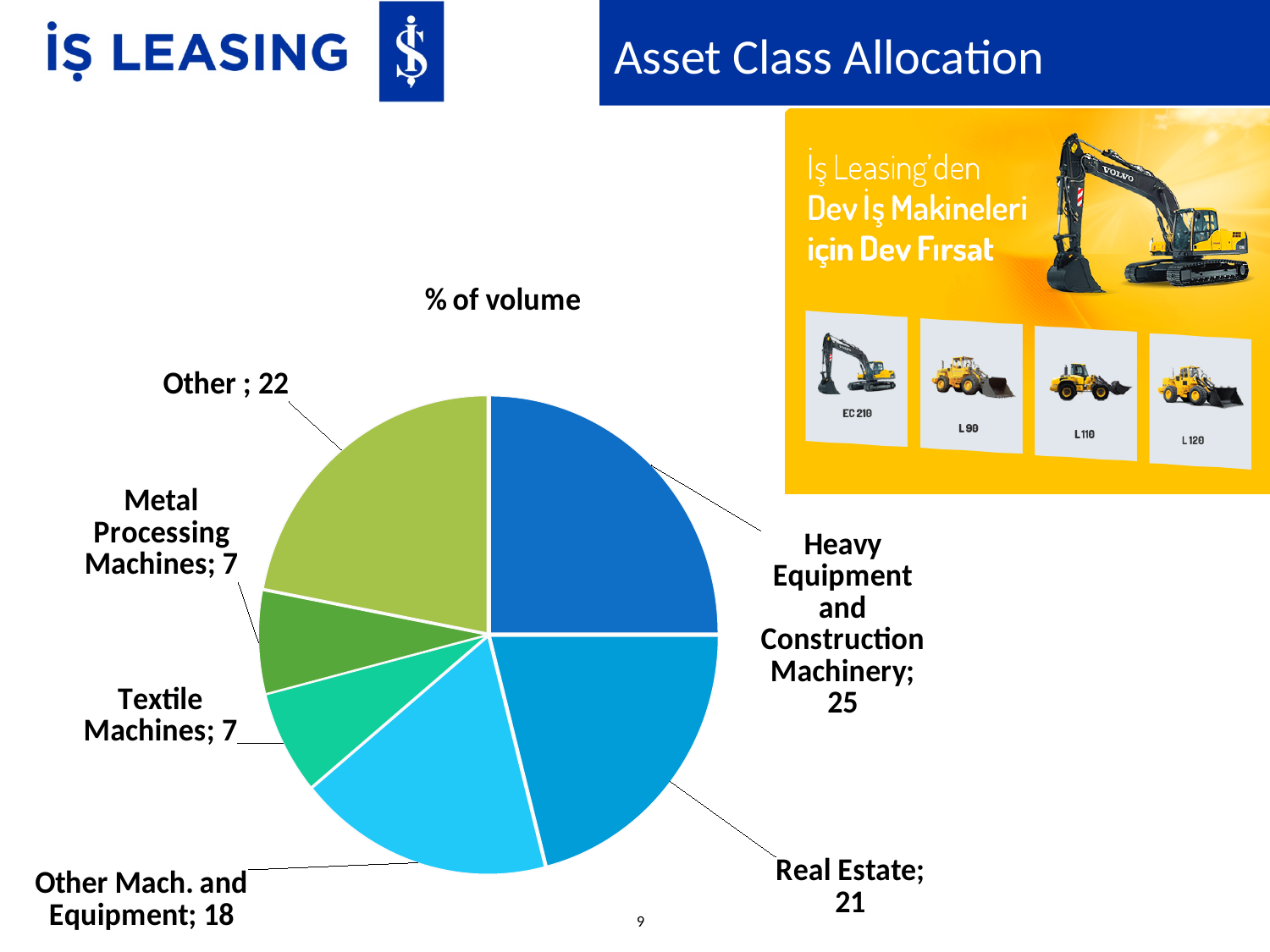
Which is larger, the value for Real Estate or the value for Other Mach. and Equipment? Real Estate What is the title of the chart? % of volume What is the combined value of Textile Machines and Metal Processing Machines? 14 What is the value for Real Estate? 21 What is the value for Other? 22 Which category has the largest slice of the pie? Heavy Equipment and Construction Machinery What is the value for Other Mach. and Equipment? 18 How many slices does the pie chart have? 6 What is the difference between the values for Other and Other Mach. and Equipment? 4 What is the value for Heavy Equipment and Construction Machinery? 25 What type of chart is shown on the slide? Pie chart What is the value for Textile Machines? 7